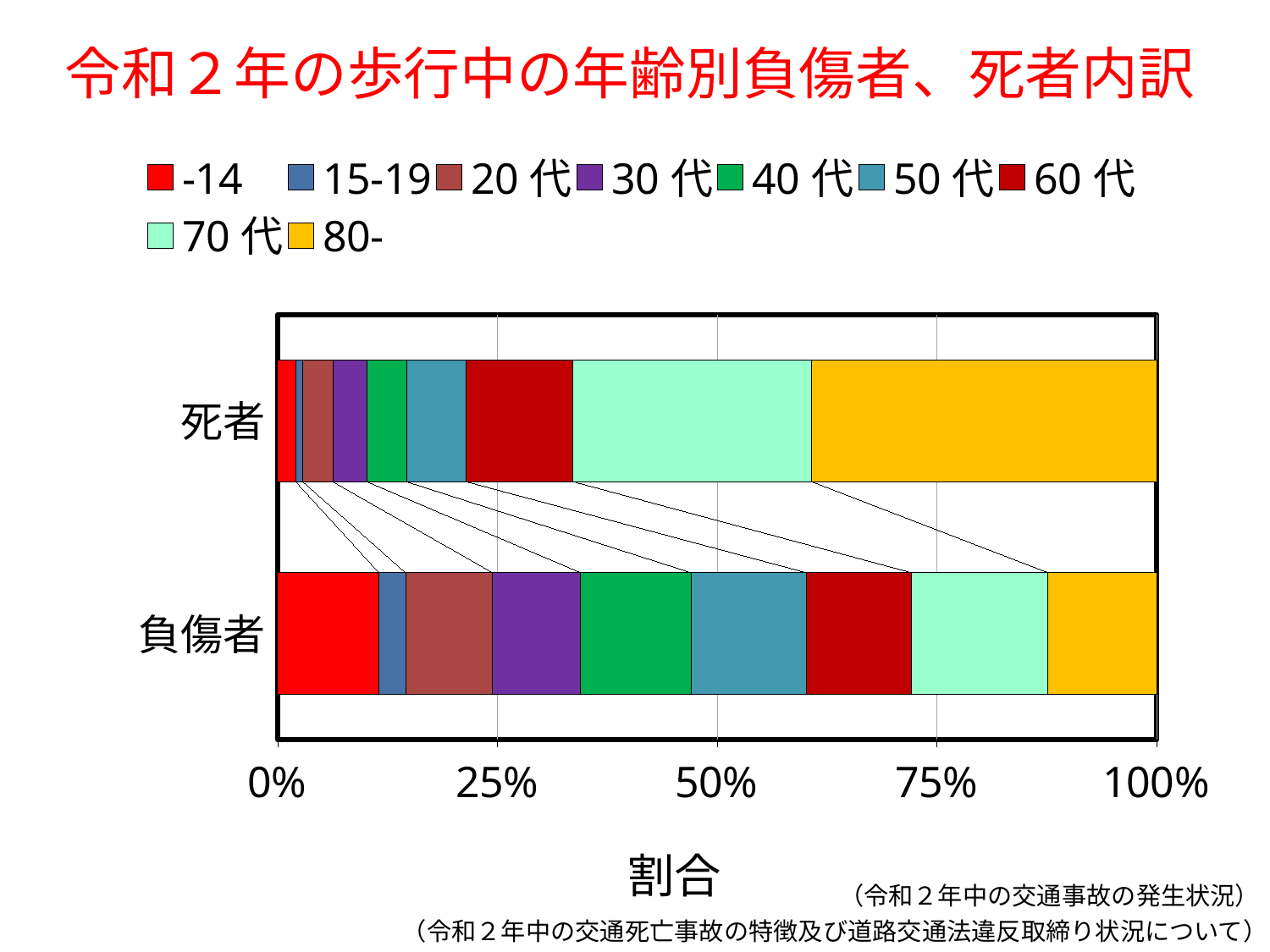
What is the label of the horizontal axis? 割合 Which age group has the smallest share of the 負傷者 bar? 15-19 Is the share of -14 larger in the 死者 bar or the 負傷者 bar? 負傷者 Which age group has the largest share of the 死者 bar? 80- Is the share of 80- larger in the 死者 bar or the 負傷者 bar? 死者 What kind of chart is shown on the slide? Stacked bar chart How many categories (bars) are plotted on the chart? 2 How many series does the legend list? 9 Is the share of 80- in the 死者 bar greater or less than 25%? greater Is the share of -14 in the 負傷者 bar greater or less than 25%? less Which age group has the smallest share of the 死者 bar? 15-19 What is the title of the chart? 令和２年の歩行中の年齢別負傷者、死者内訳